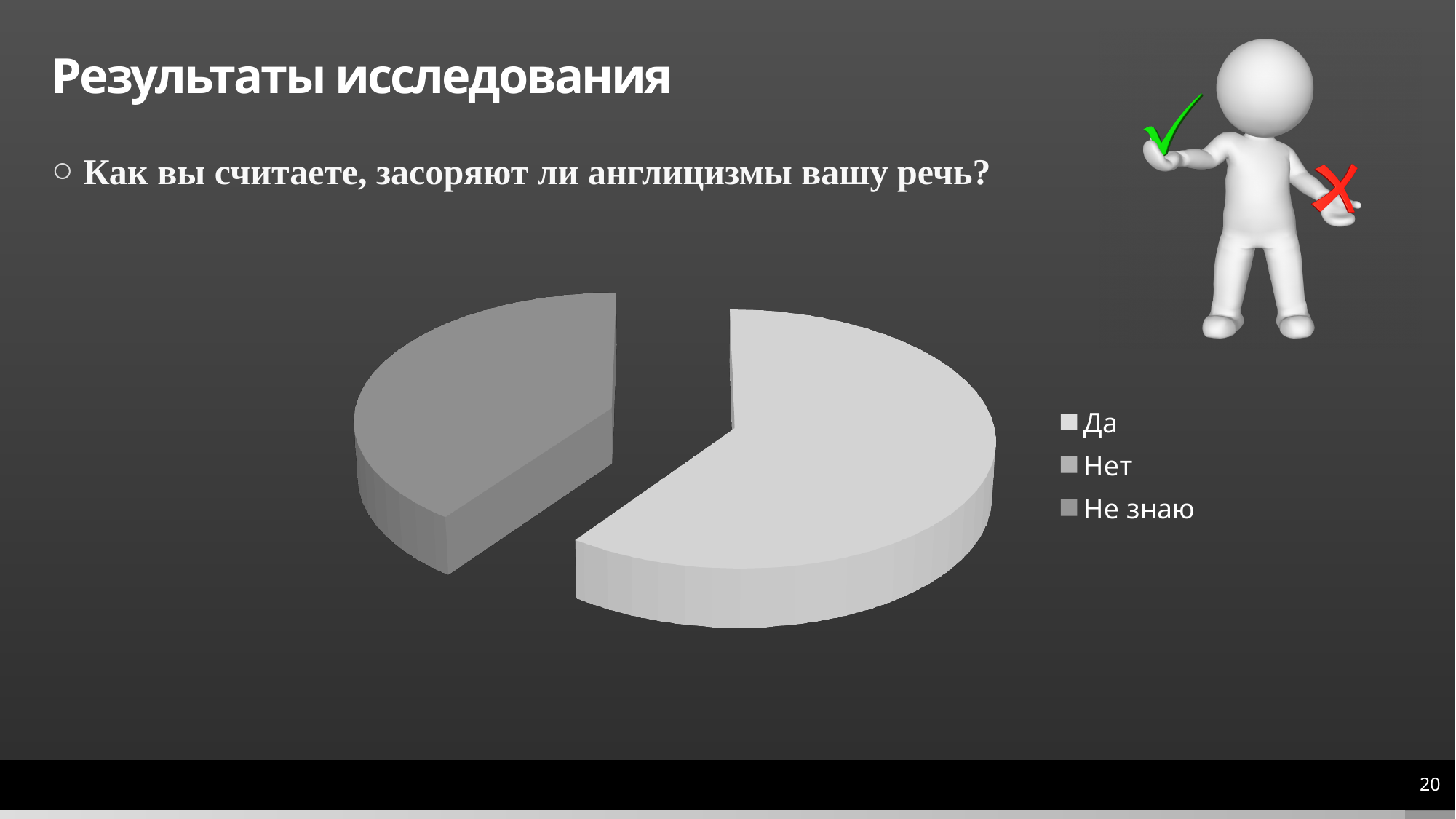
What survey question does the pie chart illustrate? Как вы считаете, засоряют ли англицизмы вашу речь? Does the Да slice take up more or less than half of the pie? more Which slice is larger, Да or Нет? Да Which category has the largest slice of the pie? Да What are the three legend entries of the pie chart? Да, Нет, Не знаю How many entries does the chart legend list? 3 What kind of chart is shown on the slide? pie chart